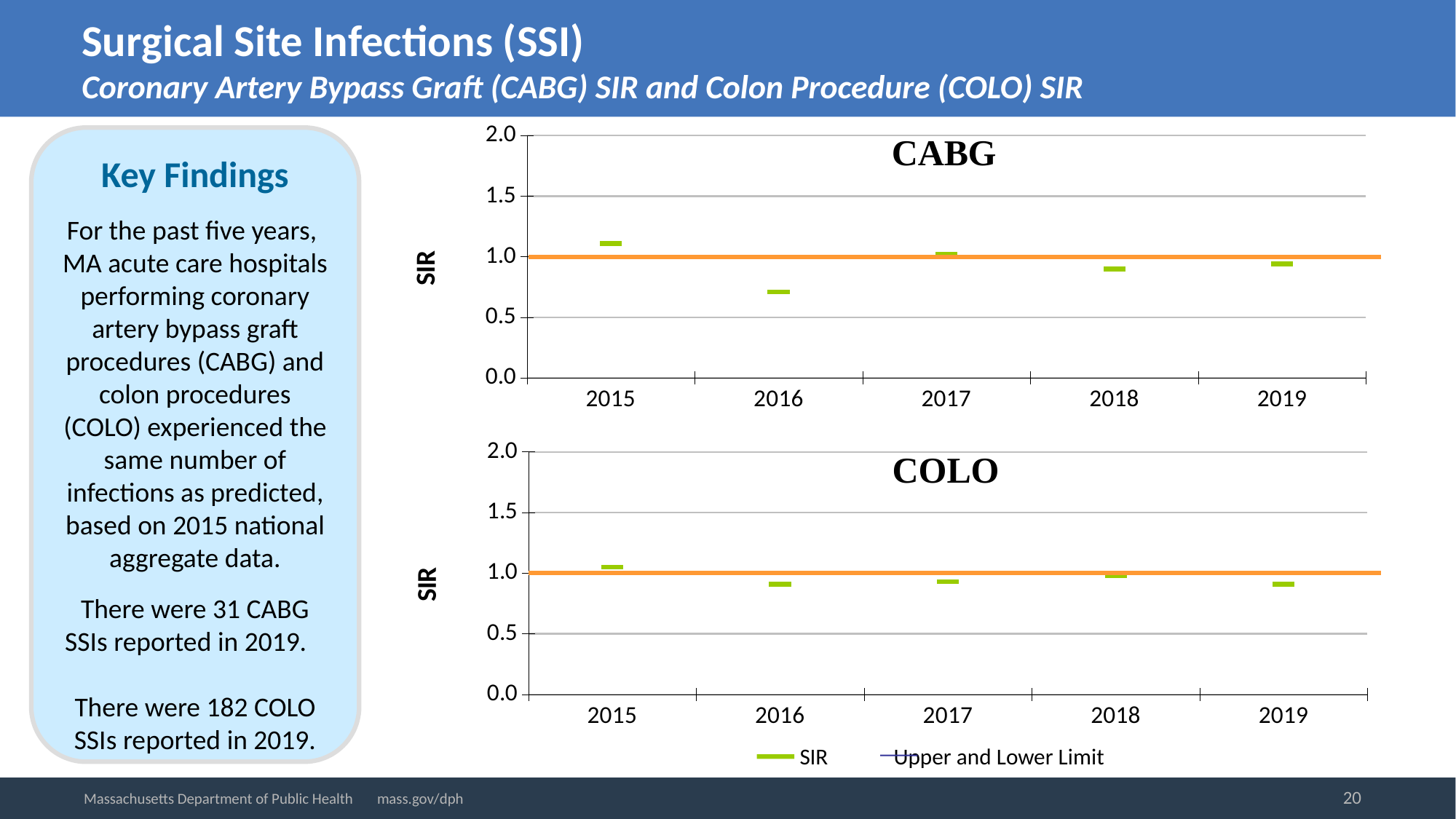
In the CABG chart, is the SIR value for 2018 greater or less than 1.0? less How many series does the legend below the COLO chart list? 2 In the COLO chart, is the SIR value for 2016 greater or less than 1.0? less In the CABG chart, which year has the larger SIR value, 2015 or 2016? 2015 In the CABG chart, is the SIR value for 2016 greater or less than 1.0? less In the CABG chart, which year has the lowest SIR value? 2016 In the CABG chart, which year has the highest SIR value? 2015 What is the label on the y axis of the CABG chart? SIR In the COLO chart, which year has the highest SIR value? 2015 How many years are plotted on the x axis of the COLO chart? 5